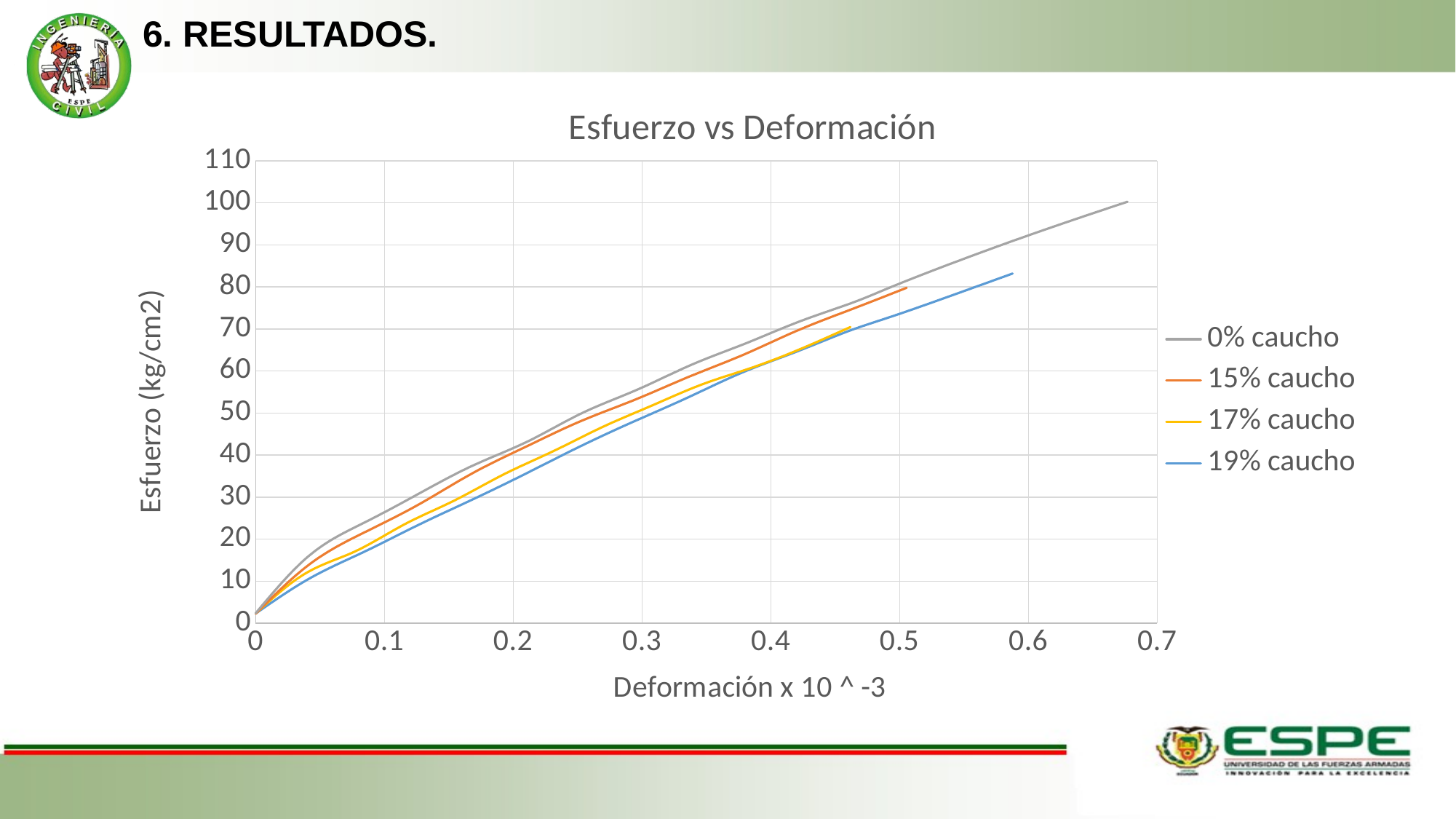
What kind of chart is shown on the slide? line chart Is the value for 19% caucho at a deformation of 0.1 greater or less than 30? less Is the highest value reached by the 0% caucho series greater or less than 90? greater Which series ends at the lowest maximum stress value? 17% caucho At a deformation of 0.2, which series has the higher stress value, 0% caucho or 19% caucho? 0% caucho How many series does the legend list? 4 Which series reaches the highest stress (Esfuerzo) value? 0% caucho Is the highest value reached by the 17% caucho series greater or less than 80? less What is the label of the vertical axis? Esfuerzo (kg/cm2) Do the values of the 0% caucho series rise or fall as deformation increases? rise What is the title of the chart? Esfuerzo vs Deformación